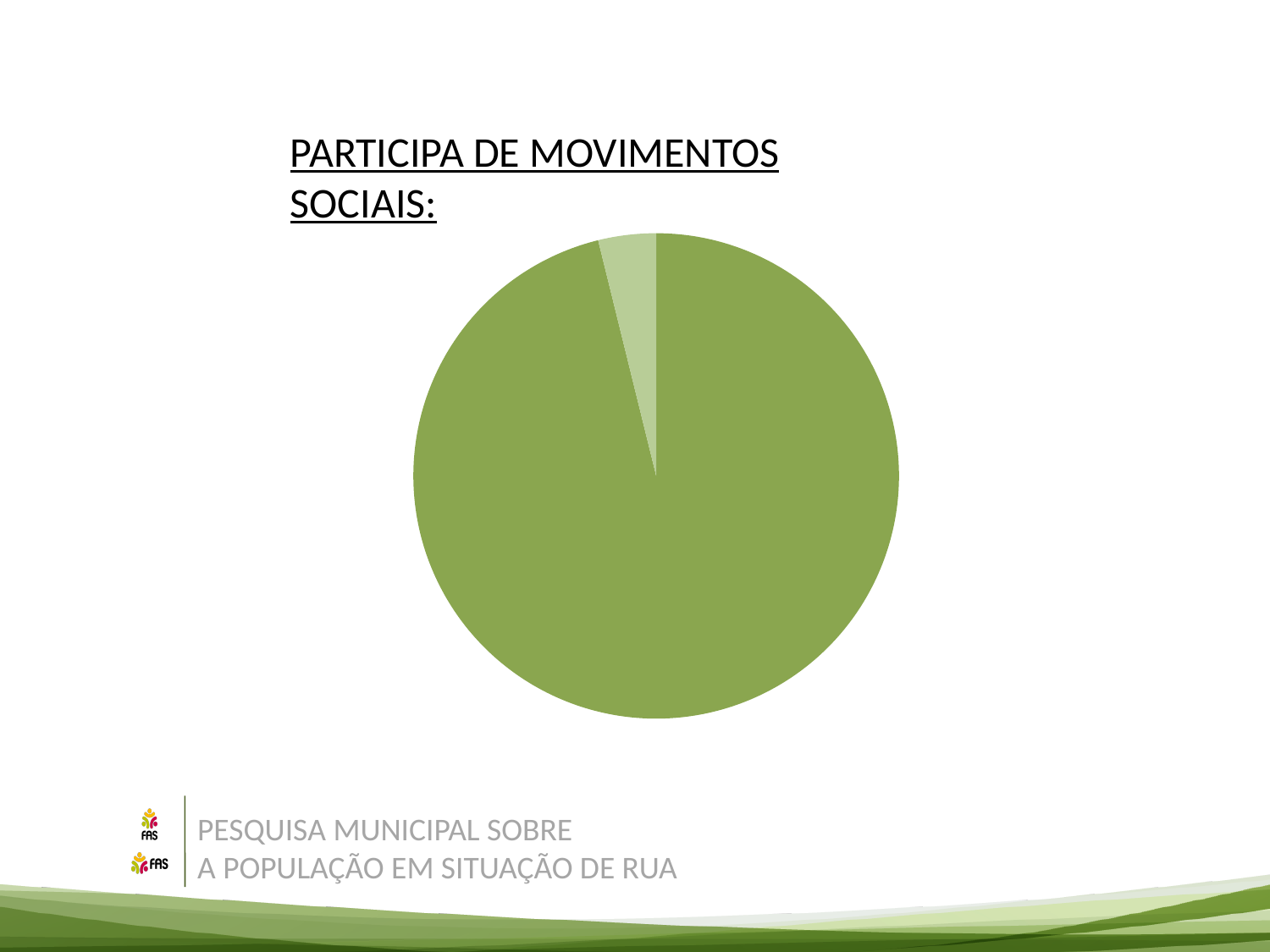
What is the title of the chart? PARTICIPA DE MOVIMENTOS SOCIAIS: How many slices does the pie chart have? 2 Which slice of the pie chart is the smallest? the light green slice What kind of chart is shown on the slide? pie chart Does the pie chart show a legend? No Which slice of the pie chart is larger, the dark green one or the light green one? the dark green one